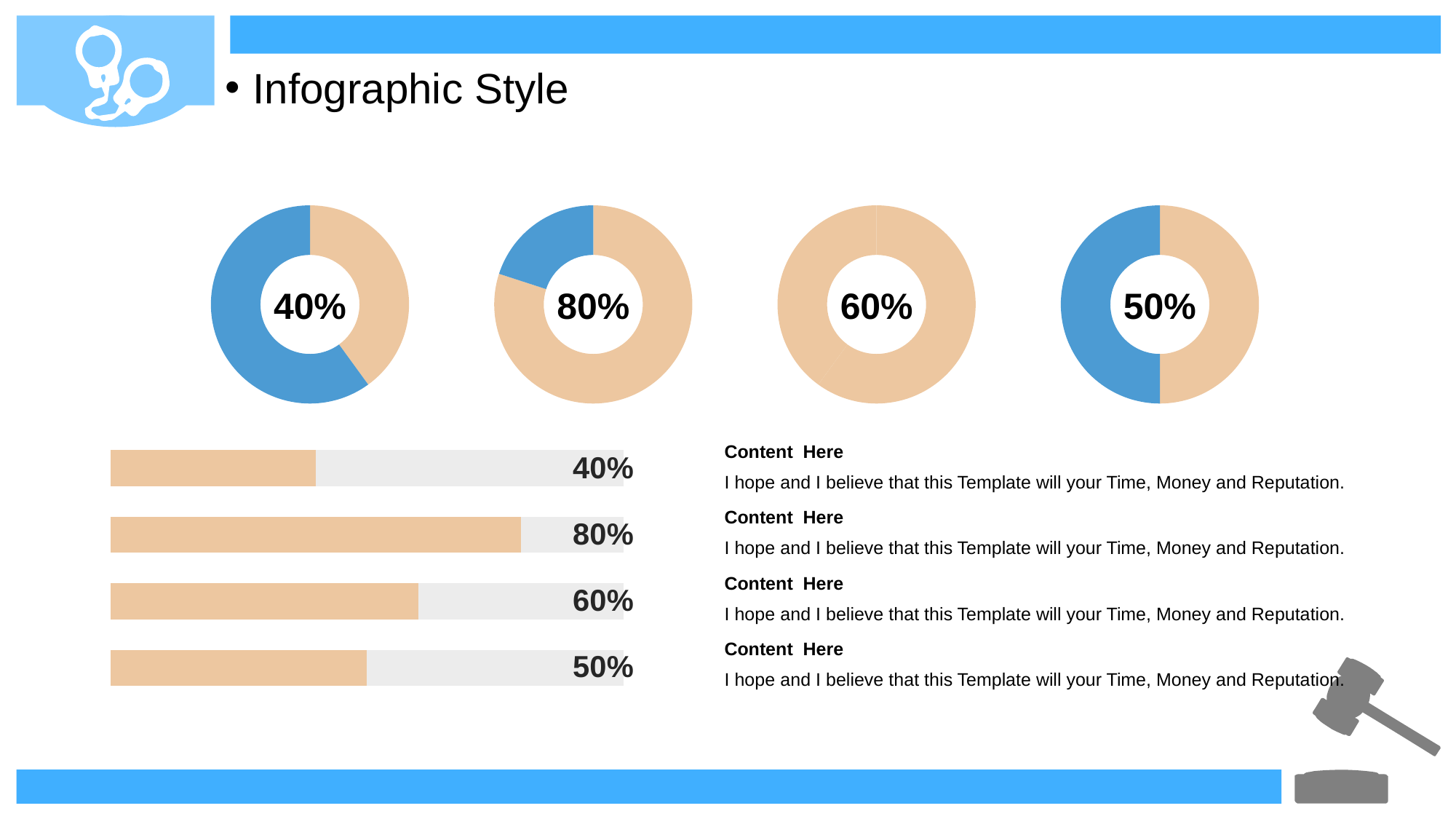
What kind of chart is shown at the bottom left of the slide? Bar chart In the horizontal bar chart at the bottom left, what is the difference between the second bar (80%) and the third bar (60%)? 20% What value is printed in the centre of the rightmost donut chart? 50% What value is printed in the centre of the second donut chart from the left? 80% In the horizontal bar chart at the bottom left, which bar has the highest value? The second bar from the top (80%) How many donut charts are shown in the top row of the slide? 4 What value is printed in the centre of the leftmost donut chart? 40% What value is printed in the centre of the third donut chart from the left? 60% In the horizontal bar chart at the bottom left, how many bars are there? 4 In the horizontal bar chart at the bottom left, which bar has the lowest value? The top bar (40%) In the horizontal bar chart at the bottom left, what value is labelled on the second bar from the top? 80% In the horizontal bar chart at the bottom left, what value is labelled on the bottom bar? 50%